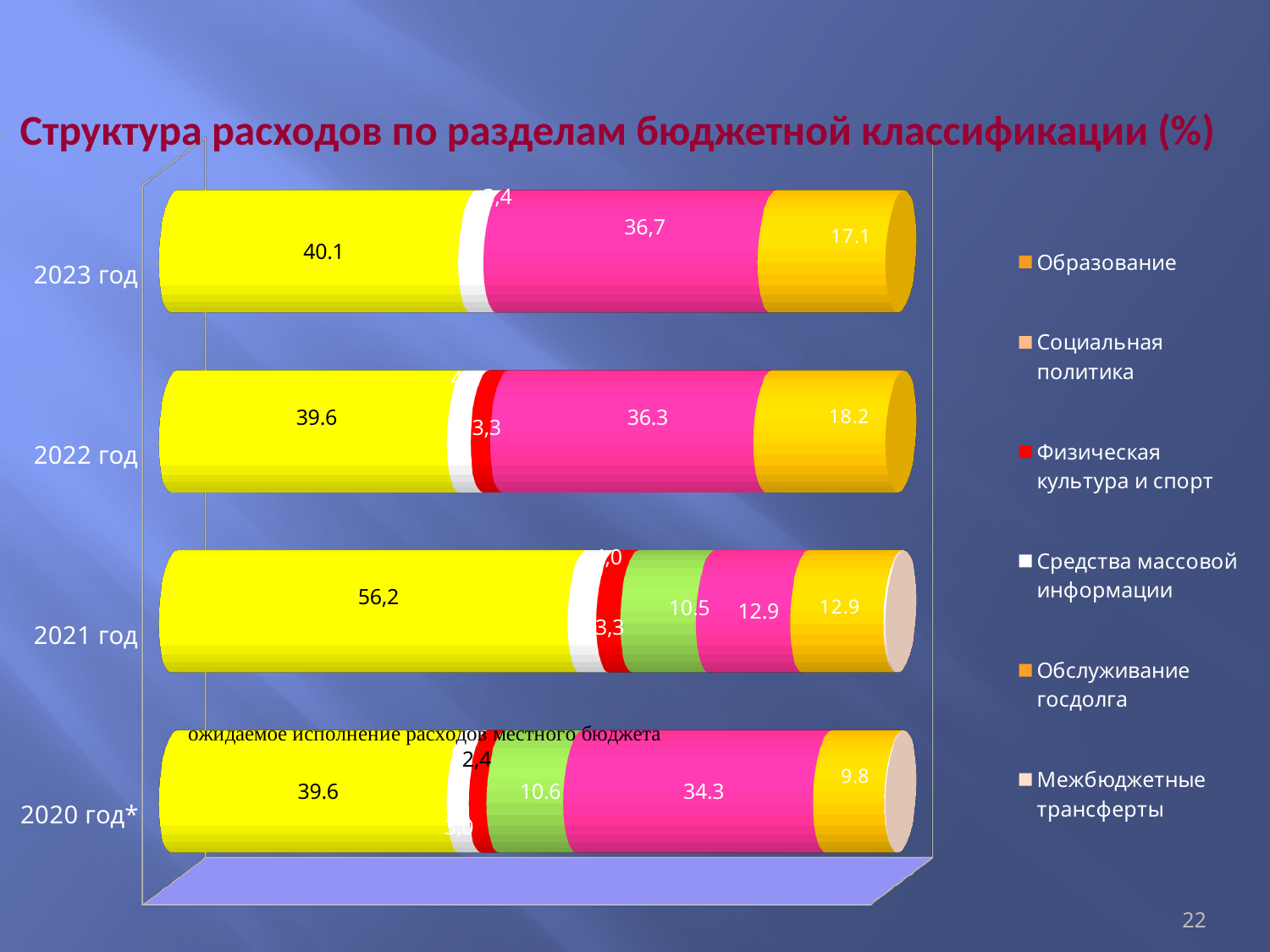
What is the title of the chart? Структура расходов по разделам бюджетной классификации (%) What is the value of the green segment for 2021 год? 10.5 What is the value of the rightmost segment for 2022 год? 18.2 What is the value of the green segment for 2020 год*? 10.6 Which year has the larger pink segment, 2022 год or 2021 год? 2022 год By how much does the yellow segment for 2021 год exceed the yellow segment for 2023 год? 16.1 What is the value of the yellow segment for 2021 год? 56,2 How many years (categories) are shown on the chart? 4 What is the value of the pink segment for 2023 год? 36,7 How many series does the legend list? 6 What kind of chart is shown on the slide? Stacked bar chart Which year has the largest yellow segment? 2021 год